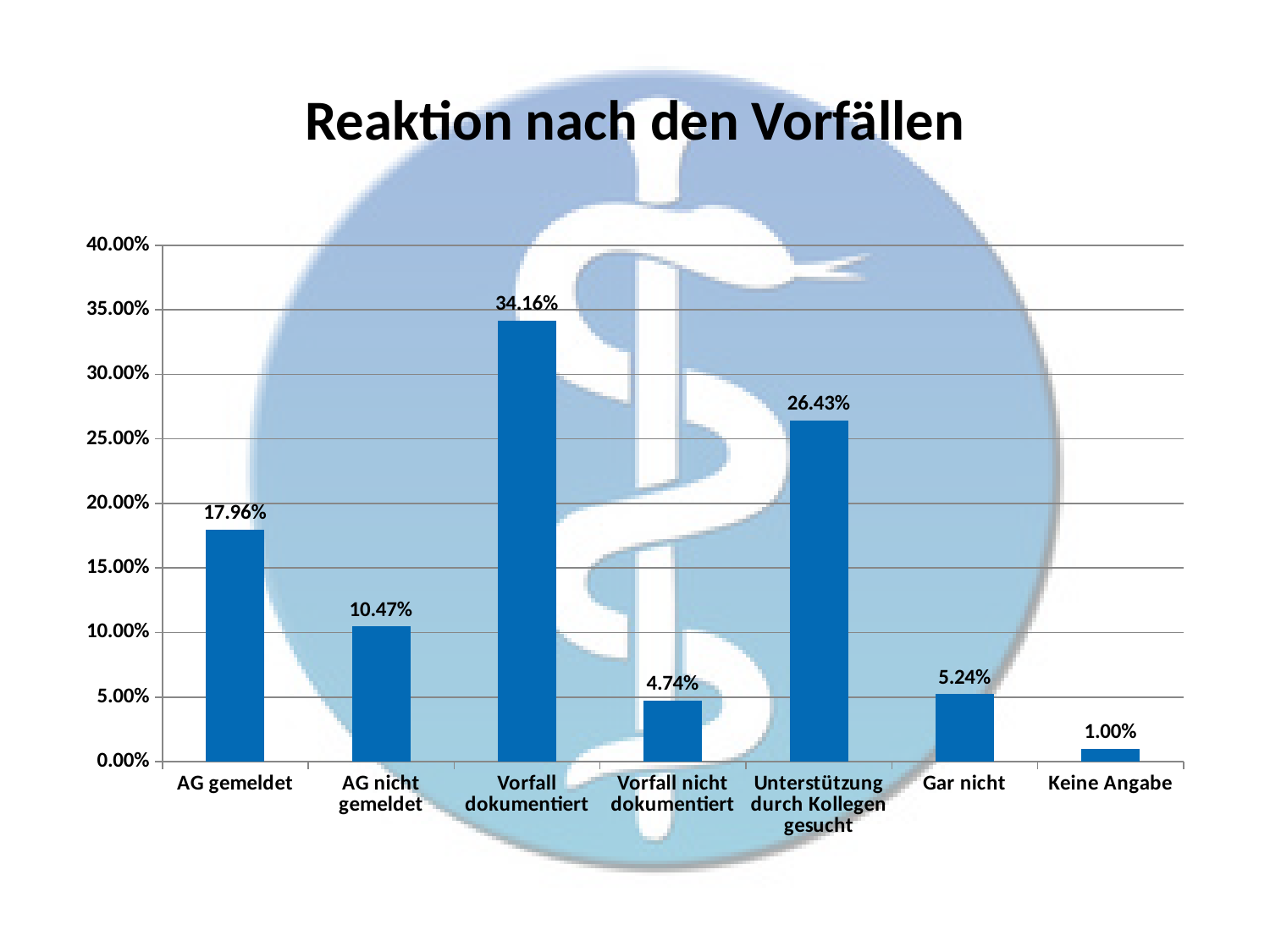
Which category has the lowest value? Keine Angabe What is the value for "Vorfall dokumentiert"? 34.16% What kind of chart is shown on the slide? bar chart Which category has the highest value? Vorfall dokumentiert What is the difference between "Vorfall dokumentiert" and "Unterstützung durch Kollegen gesucht"? 7.73% What is the value for "Unterstützung durch Kollegen gesucht"? 26.43% What is the value for "AG gemeldet"? 17.96% Is the value for "Gar nicht" greater or less than 10.00%? less Which is larger, "AG gemeldet" or "AG nicht gemeldet"? AG gemeldet What is the title of the chart? Reaktion nach den Vorfällen What is the value for "Keine Angabe"? 1.00% How many categories are shown on the x axis? 7